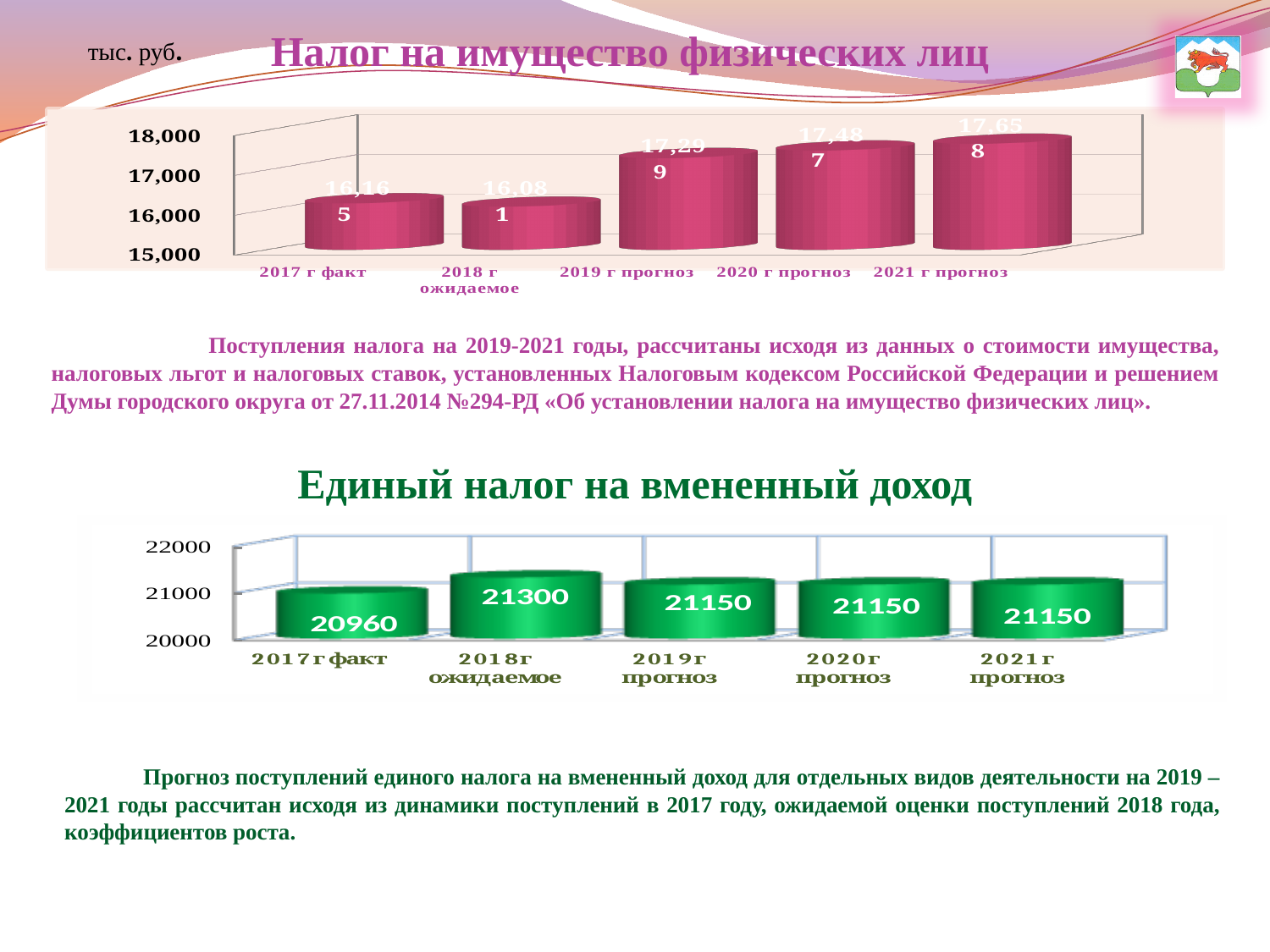
In the chart titled 'Единый налог на вмененный доход', how many categories are shown on the x axis? 5 In the chart titled 'Единый налог на вмененный доход', which category has the lowest value? 2017 г факт In the chart titled 'Налог на имущество физических лиц', which is larger, the value for '2019 г прогноз' or '2018 г ожидаемое'? 2019 г прогноз In the chart titled 'Единый налог на вмененный доход', what is the value for '2017 г факт'? 20960 What kind of chart is the chart titled 'Единый налог на вмененный доход'? bar chart In the chart titled 'Единый налог на вмененный доход', what is the difference between the values for '2018 г ожидаемое' and '2017 г факт'? 340 In the chart titled 'Налог на имущество физических лиц', is the value for '2021 г прогноз' greater or less than 17,000? greater In the chart titled 'Налог на имущество физических лиц', how many bars are shown? 5 In the chart titled 'Налог на имущество физических лиц', is the value for '2017 г факт' greater or less than 17,000? less In the chart titled 'Единый налог на вмененный доход', which category has the highest value? 2018 г ожидаемое In the chart titled 'Единый налог на вмененный доход', what is the value for '2018 г ожидаемое'? 21300 In the chart titled 'Единый налог на вмененный доход', what is the value for '2021 г прогноз'? 21150